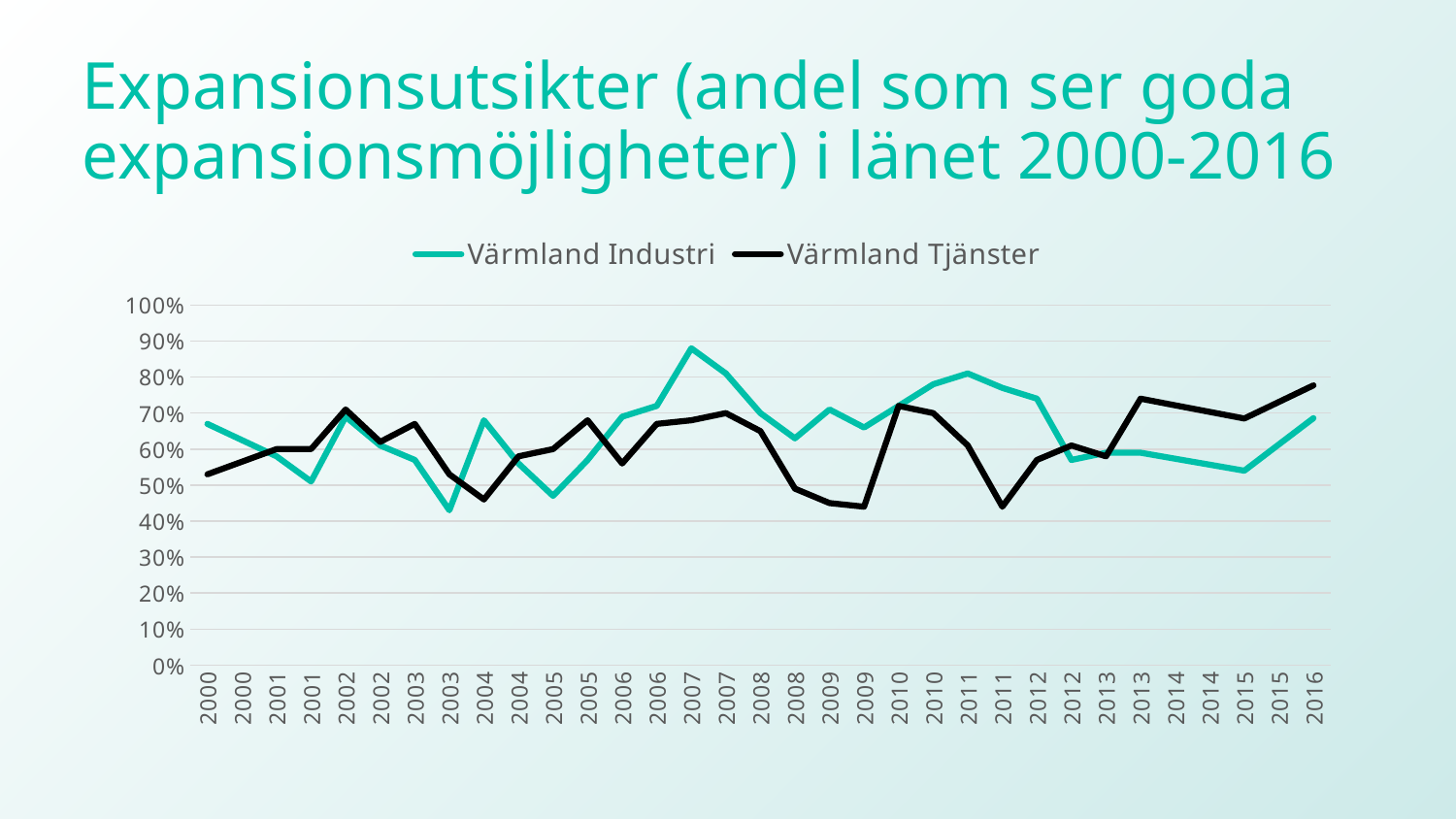
What kind of chart is shown on the slide? line chart Is the peak value for Värmland Industri in 2007 greater or less than 80%? greater In 2016, which series has the higher value, Värmland Industri or Värmland Tjänster? Värmland Tjänster Is the lowest value for Värmland Industri in 2003 greater or less than 50%? less Is the value for Värmland Tjänster in 2016 greater or less than 70%? greater Which two series are listed in the legend? Värmland Industri and Värmland Tjänster At the first 2007 point, which series has the higher value, Värmland Industri or Värmland Tjänster? Värmland Industri Which series is drawn with the black line? Värmland Tjänster At which year does Värmland Industri reach its lowest value? 2003 At which year does Värmland Industri reach its highest value? 2007 How many series does the legend list? 2 From the second 2011 point to 2016, does Värmland Tjänster generally rise or fall? rise